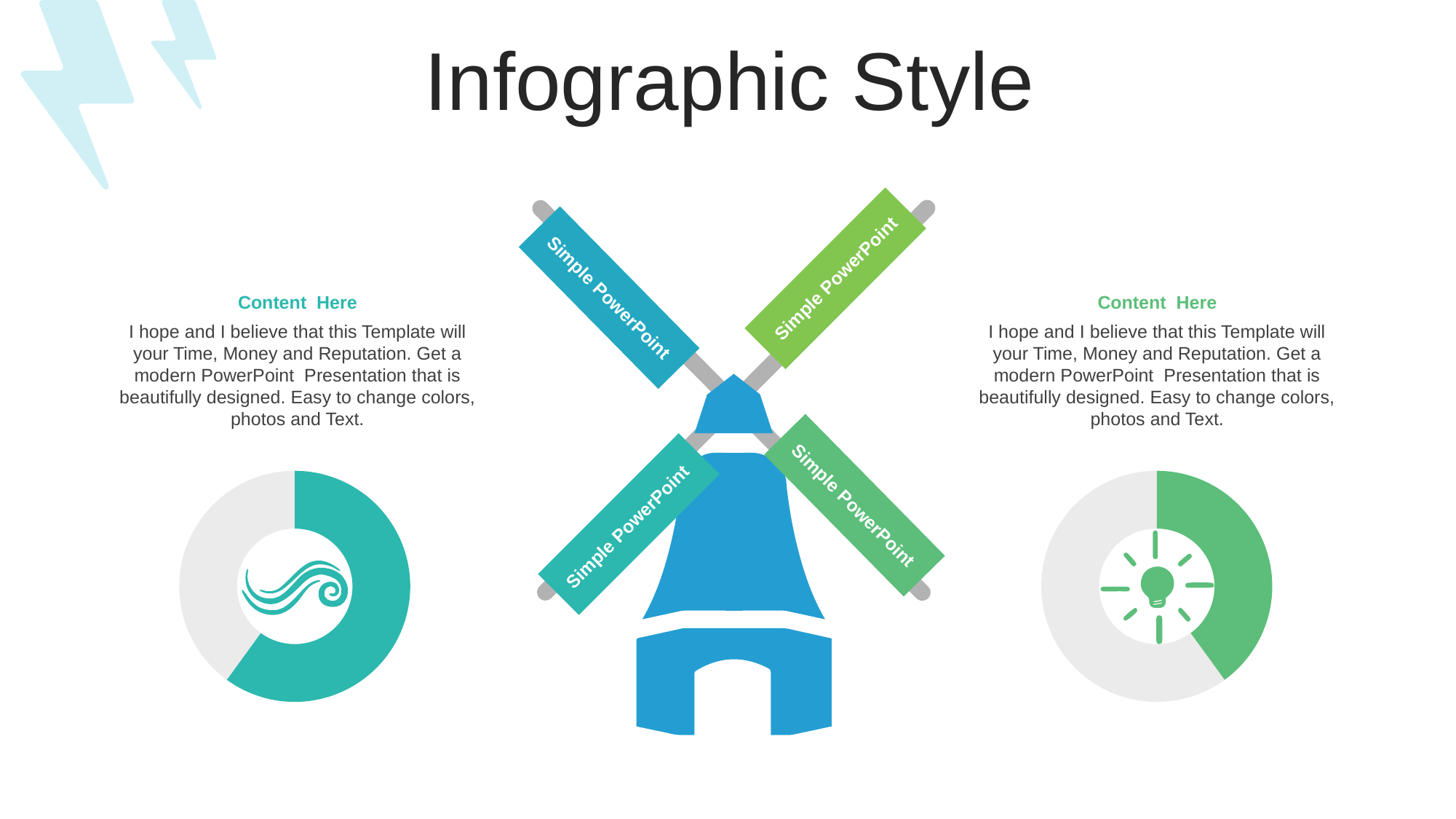
In the left doughnut chart, which slice is larger, the teal slice or the grey slice? Teal In the right doughnut chart, which slice is larger, the green slice or the grey slice? Grey What kind of chart is shown on the left side of the slide, below the left 'Content Here' text? Doughnut chart What colour is the coloured (non-grey) slice of the left doughnut chart? Teal How many doughnut charts are on the slide? 2 In the right doughnut chart, which slice is the largest? Grey In the right doughnut chart, how many slices are there? 2 What kind of chart is shown on the right side of the slide, below the right 'Content Here' text? Doughnut chart In the left doughnut chart, which slice is the smallest? Grey In the left doughnut chart, how many slices are there? 2 What icon appears in the centre of the right doughnut chart? A light bulb